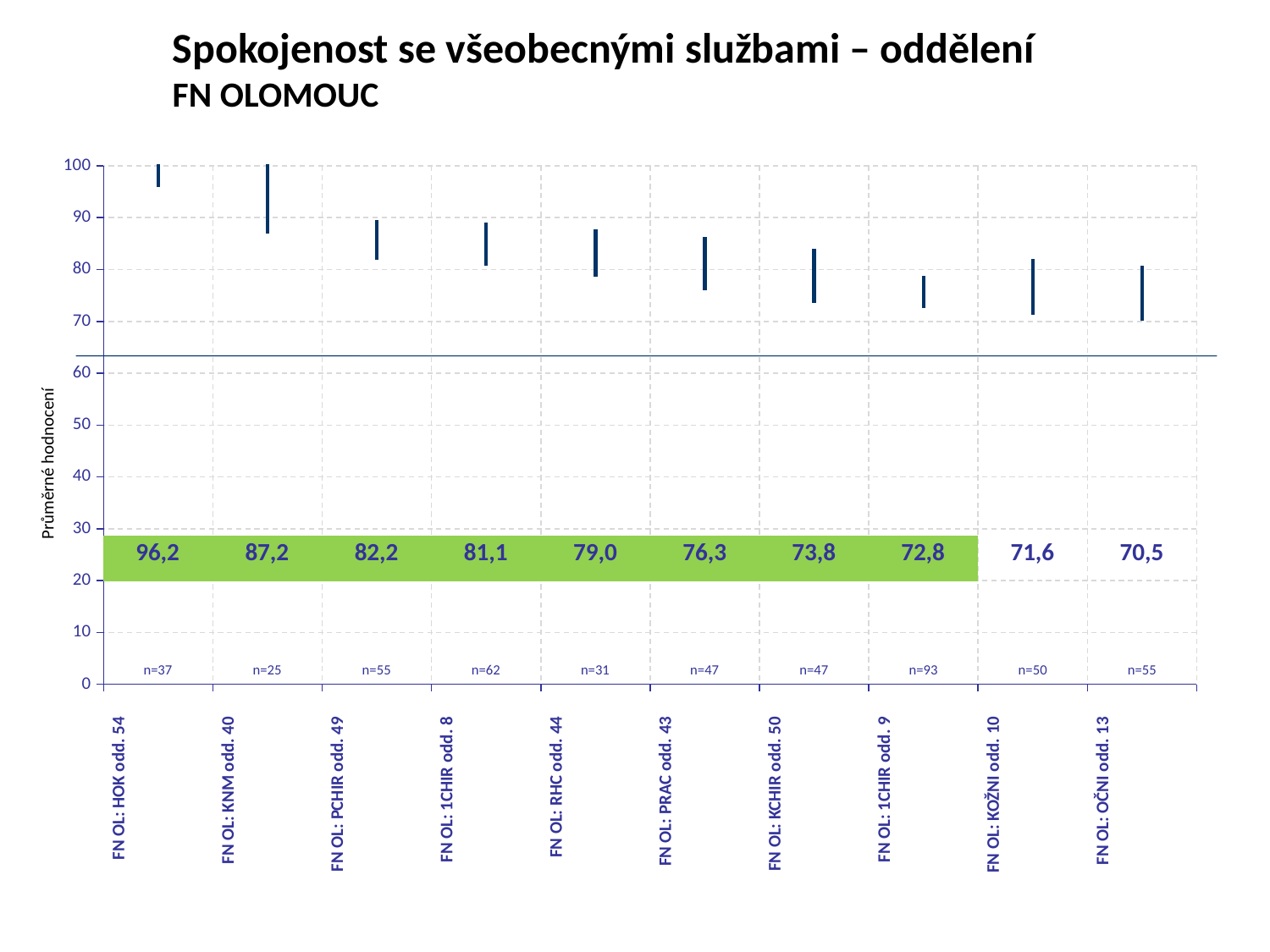
What is the label of the vertical axis? Průměrné hodnocení What is the average rating (průměrné hodnocení) for FN OL: HOK odd. 54? 96,2 Which has a higher average rating, FN OL: PCHIR odd. 49 or FN OL: KCHIR odd. 50? FN OL: PCHIR odd. 49 What is the average rating for FN OL: RHC odd. 44? 79,0 What is the difference between the average ratings of FN OL: HOK odd. 54 and FN OL: KNM odd. 40? 9,0 What is the difference between the average ratings of FN OL: 1CHIR odd. 8 and FN OL: 1CHIR odd. 9? 8,3 Which department has the lowest average rating? FN OL: OČNI odd. 13 What is the sample size (n) shown for FN OL: 1CHIR odd. 9? n=93 Which department has the highest average rating? FN OL: HOK odd. 54 How many departments are shown on the chart? 10 What is the average rating for FN OL: OČNI odd. 13? 70,5 Do the average ratings rise or fall from left to right along the x axis? fall